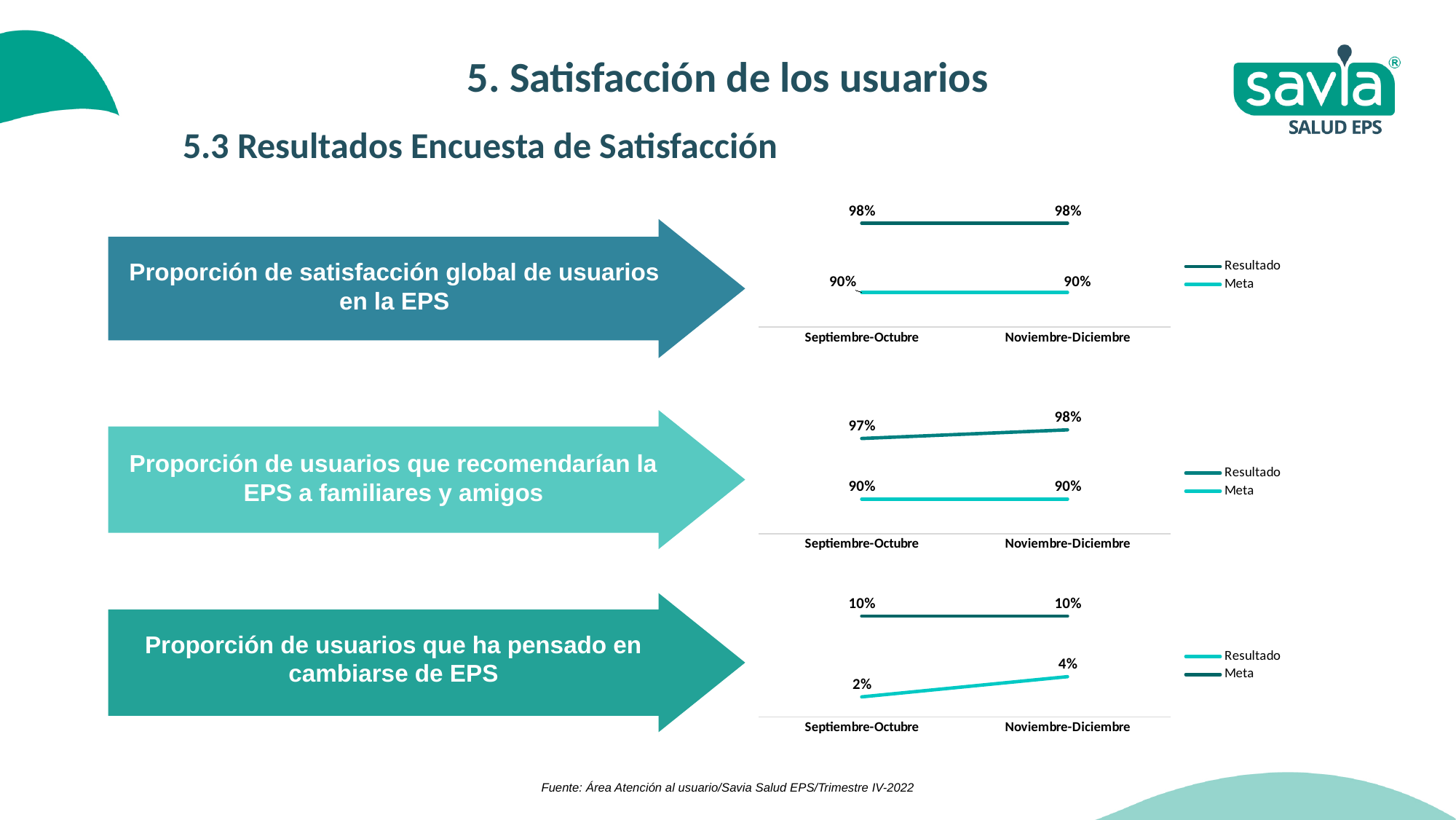
In the middle chart (Proporción de usuarios que recomendarían la EPS a familiares y amigos), what is the difference between the Resultado values for Noviembre-Diciembre and Septiembre-Octubre? 1% In the middle chart (Proporción de usuarios que recomendarían la EPS a familiares y amigos), what is the Resultado value for Septiembre-Octubre? 97% In the bottom chart (Proporción de usuarios que ha pensado en cambiarse de EPS), which is larger for Noviembre-Diciembre, the Resultado or the Meta? Meta In the top chart (Proporción de satisfacción global de usuarios en la EPS), what is the Meta value for Septiembre-Octubre? 90% How many series does the legend of the top chart (Proporción de satisfacción global de usuarios en la EPS) list? 2 In the top chart (Proporción de satisfacción global de usuarios en la EPS), what is the difference between the Resultado and the Meta for Noviembre-Diciembre? 8% In the top chart (Proporción de satisfacción global de usuarios en la EPS), what is the Resultado value for Noviembre-Diciembre? 98% In the bottom chart (Proporción de usuarios que ha pensado en cambiarse de EPS), what is the Meta value for Septiembre-Octubre? 10% In the bottom chart (Proporción de usuarios que ha pensado en cambiarse de EPS), what is the difference between the Meta and the Resultado for Septiembre-Octubre? 8% What kind of chart is the middle chart (Proporción de usuarios que recomendarían la EPS a familiares y amigos)? line chart In the middle chart (Proporción de usuarios que recomendarían la EPS a familiares y amigos), does the Resultado line rise or fall from Septiembre-Octubre to Noviembre-Diciembre? rise In the bottom chart (Proporción de usuarios que ha pensado en cambiarse de EPS), what is the Resultado value for Noviembre-Diciembre? 4%